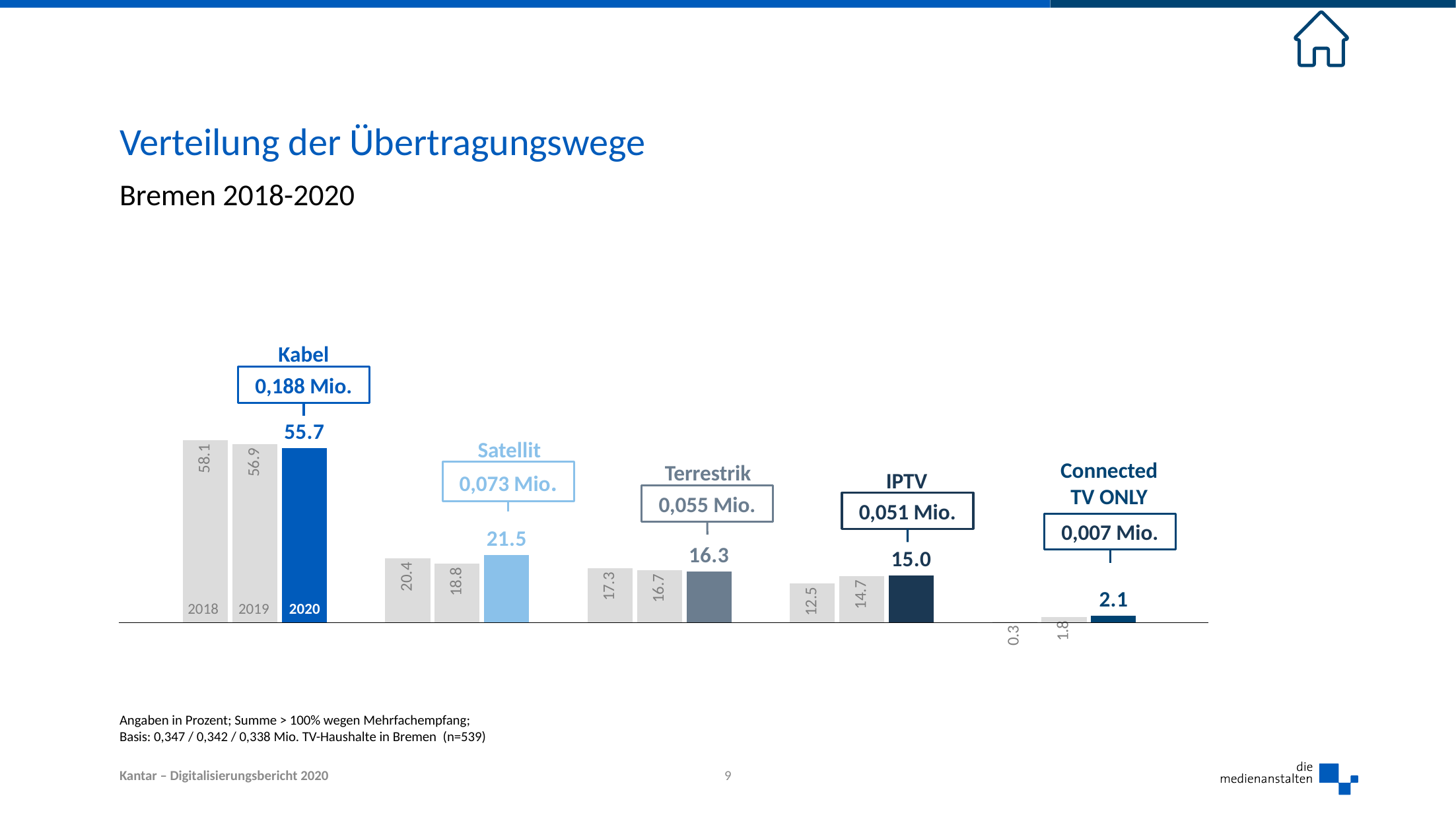
What is the value for Satellit in 2018? 20.4 Which category has the highest value in 2020? Kabel How many years are shown for each category? 3 What is the value for Kabel in 2020? 55.7 What is the value for Connected TV ONLY in 2020? 2.1 Do the values for IPTV rise or fall from 2018 to 2020? Rise What kind of chart is shown on the slide? Bar chart How many categories (transmission paths) are shown in the chart? 5 What is the difference between the Kabel values for 2018 and 2020? 2.4 Which is larger, Terrestrik in 2020 or IPTV in 2020? Terrestrik in 2020 What is the value for IPTV in 2019? 14.7 Which category has the lowest value in 2018? Connected TV ONLY